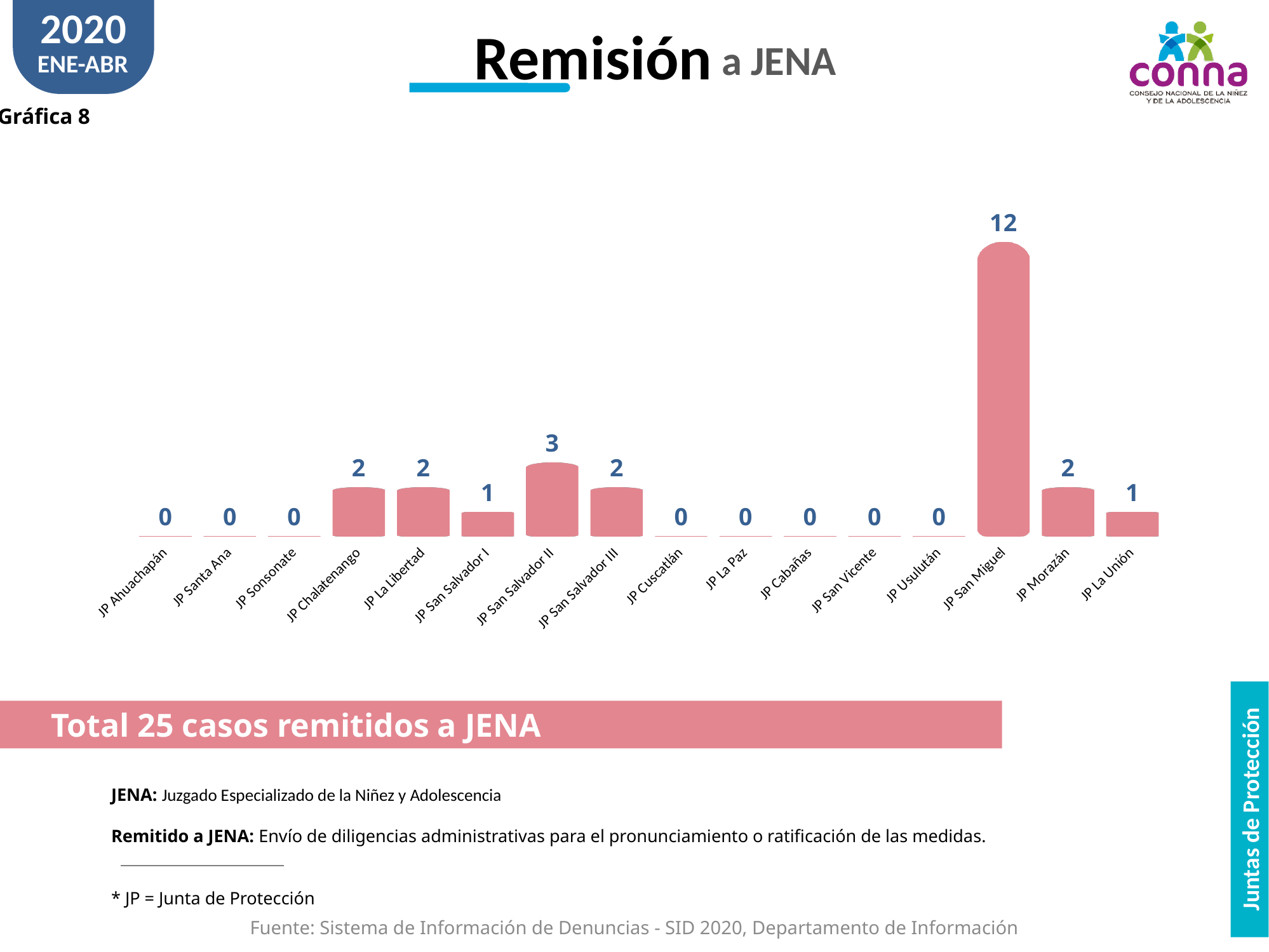
What is the value for JP San Salvador II? 3 What is the difference between the values for JP Morazán and JP San Salvador I? 1 What is the total number of cases remitted to JENA stated on the slide? 25 How many categories are shown on the x axis? 16 What is the difference between the values for JP San Miguel and JP San Salvador II? 9 Which category has the highest value? JP San Miguel What kind of chart is shown on the slide? Bar chart What is the value for JP Chalatenango? 2 Which is larger, the value for JP San Salvador II or the value for JP San Salvador III? JP San Salvador II What is the value for JP La Unión? 1 How many categories have a value of 0? 8 What is the value for JP San Miguel? 12